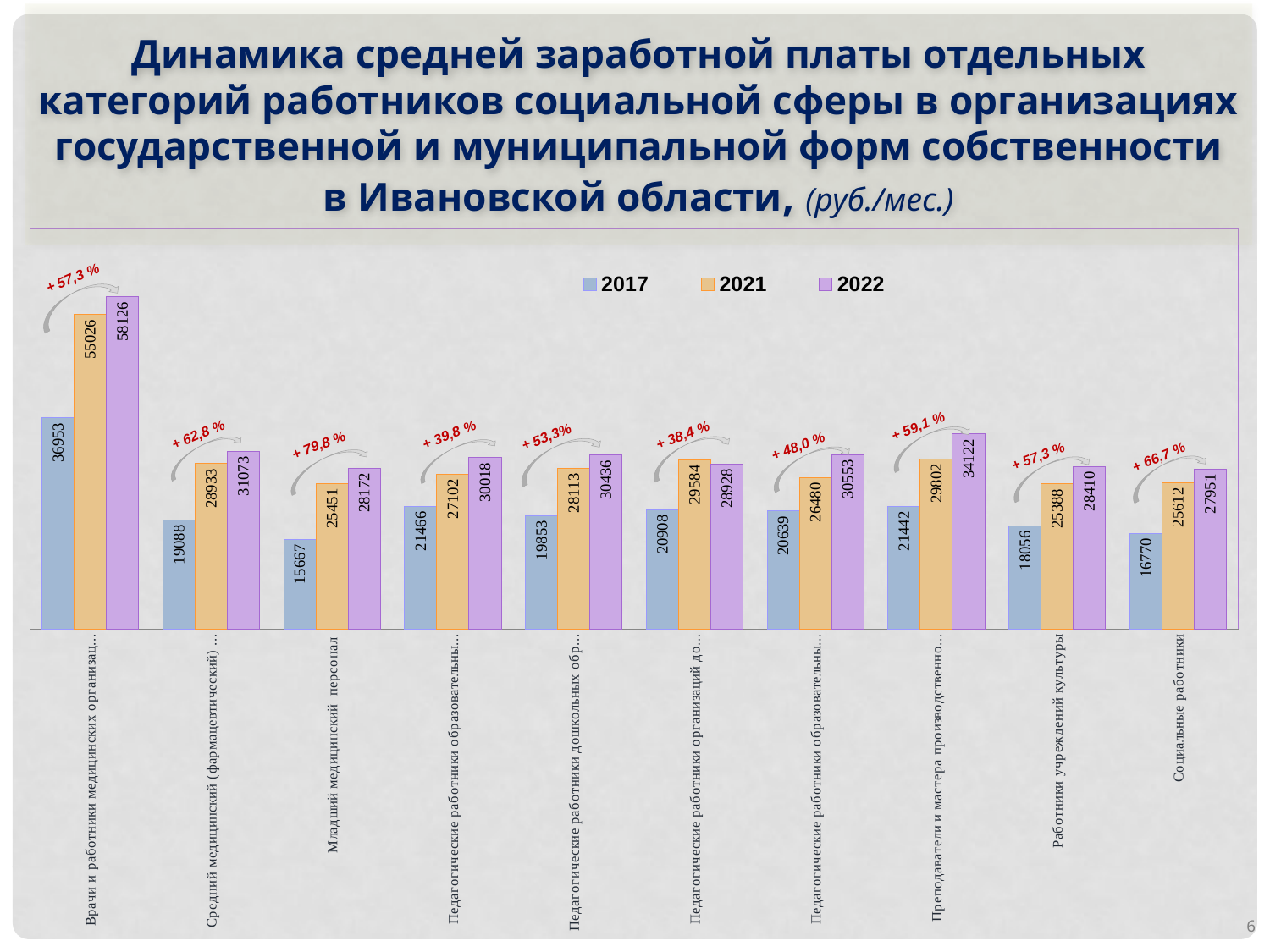
What is the 2021 value for Работники учреждений культуры? 25388 What is the highest value shown anywhere in the chart? 58126 What kind of chart is shown on the slide? bar chart What is the 2017 value for Младший медицинский персонал? 15667 Which has the larger 2022 value: Работники учреждений культуры or Социальные работники? Работники учреждений культуры How many series does the legend list? 3 Which category has the lowest 2017 value? Младший медицинский персонал What is the difference between the 2022 and 2017 values for Социальные работники? 11181 What percentage change is annotated above the bars for Младший медицинский персонал? + 79,8 % What is the 2022 value for Социальные работники? 27951 How many categories of workers are shown on the x axis? 10 Do the values for Младший медицинский персонал rise or fall from 2017 to 2022? rise